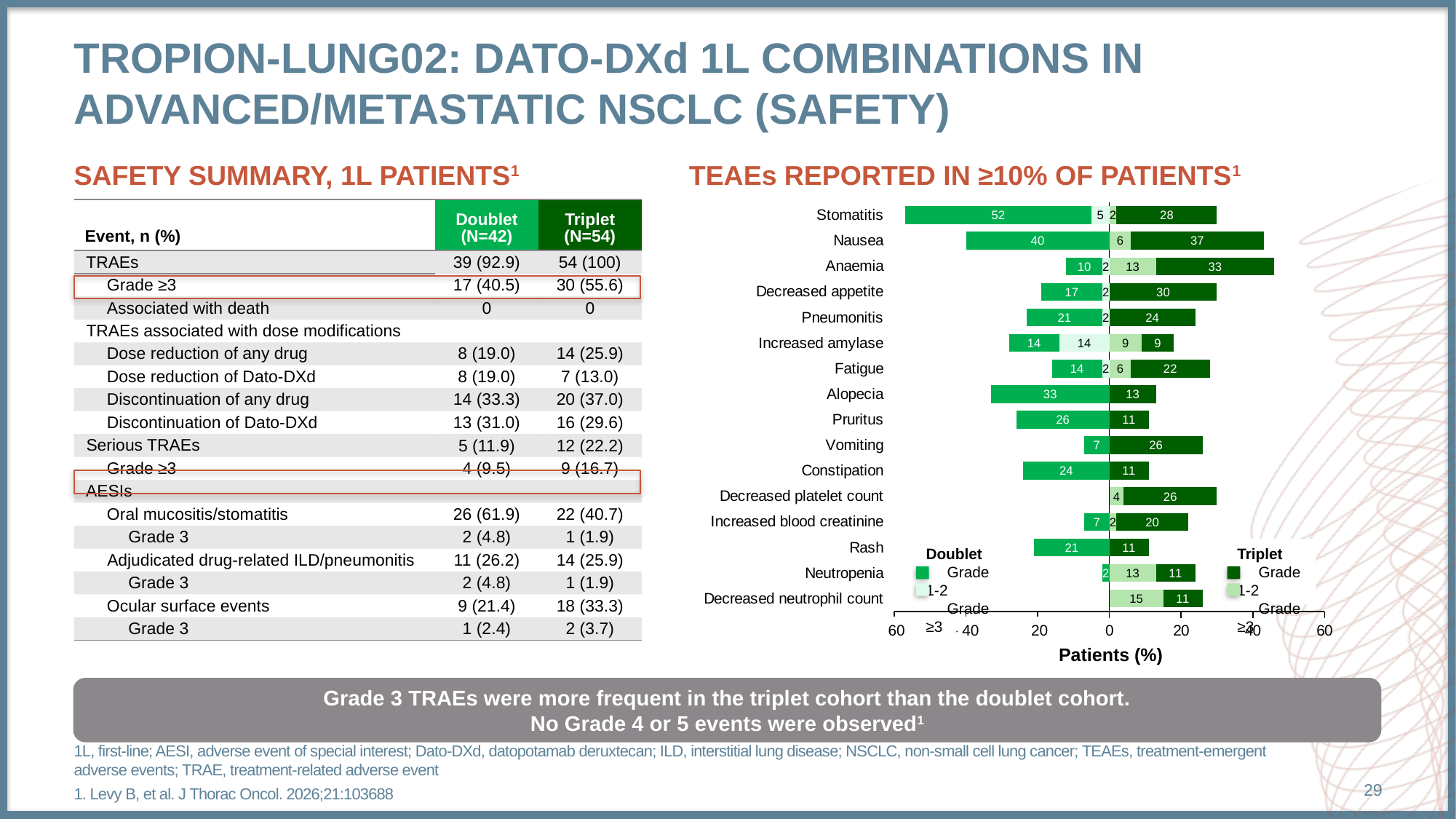
In the TEAEs chart, which adverse event has the longest Doublet bar? Stomatitis How many series does the legend of the TEAEs chart list? 4 In the TEAEs chart, what is the total percentage of Triplet patients with Anaemia (sum of both grade segments)? 46 In the TEAEs chart, how many percentage points higher is Vomiting in the Triplet cohort than in the Doublet cohort? 19 What is the x-axis title of the TEAEs chart? Patients (%) How many adverse events are listed on the y axis of the TEAEs chart? 16 In the TEAEs chart, what is the total percentage of Doublet patients with Stomatitis (sum of both grade segments)? 57 What kind of chart is used to show the TEAEs reported in ≥10% of patients? Bar chart In the TEAEs chart, what percentage of Doublet patients had Pruritus? 26 In the TEAEs chart, what percentage of Triplet patients had Vomiting? 26 In the TEAEs chart, which cohort has the higher percentage of patients with Alopecia, Doublet or Triplet? Doublet In the TEAEs chart, what percentage of Doublet patients had Alopecia? 33